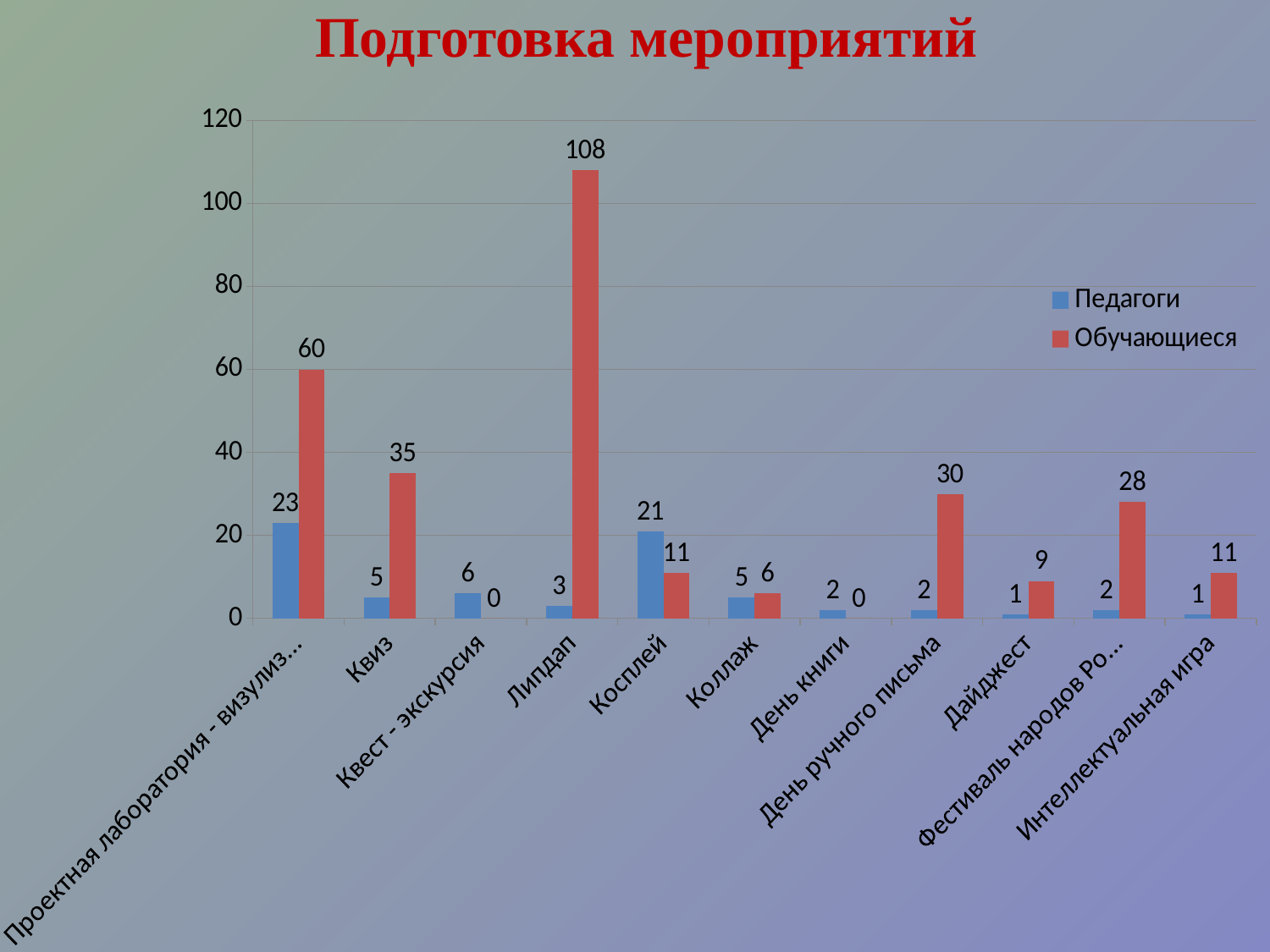
What is the difference between the Обучающиеся and Педагоги values for День ручного письма? 28 Which is larger for Косплей: the value for Педагоги or for Обучающиеся? Педагоги How many series does the legend list? 2 Which category has the highest value for Педагоги? Проектная лаборатория - визулиз... How many categories are shown on the x axis? 11 Which category has the highest value for Обучающиеся? Липдап What kind of chart is shown on the slide? bar chart What is the value for Педагоги for Квест - экскурсия? 6 What is the value for Обучающиеся for Квиз? 35 Is the value for Обучающиеся for Липдап greater or less than 100? greater What is the value for Педагоги for Косплей? 21 What is the value for Обучающиеся for Липдап? 108